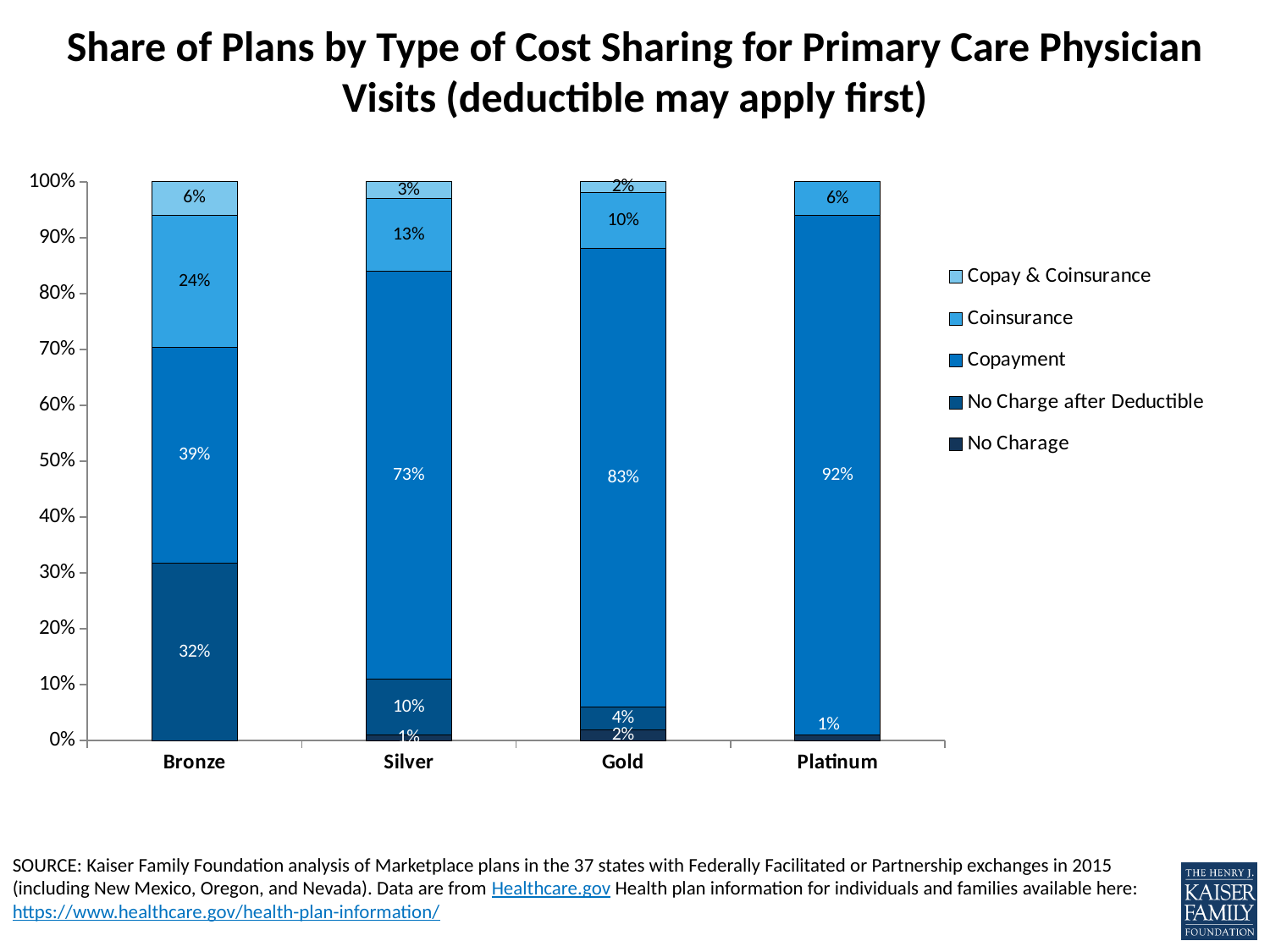
What share of Silver plans use Coinsurance? 13% What share of Silver plans have No Charge after Deductible? 10% How many plan types are shown on the x axis? 4 How many percentage points higher is the Copayment share for Gold than for Silver? 10 percentage points Which plan type has the lowest share of plans using a Copayment? Bronze How many cost-sharing types does the legend list? 5 What share of Bronze plans use Copay & Coinsurance? 6% Does the Copayment share rise or fall moving from Bronze to Platinum? Rises What share of Platinum plans use a Copayment for primary care physician visits? 92% What share of Bronze plans use a Copayment? 39% Which has a larger Coinsurance share, Bronze or Gold? Bronze Which plan type has the highest share of plans using a Copayment? Platinum